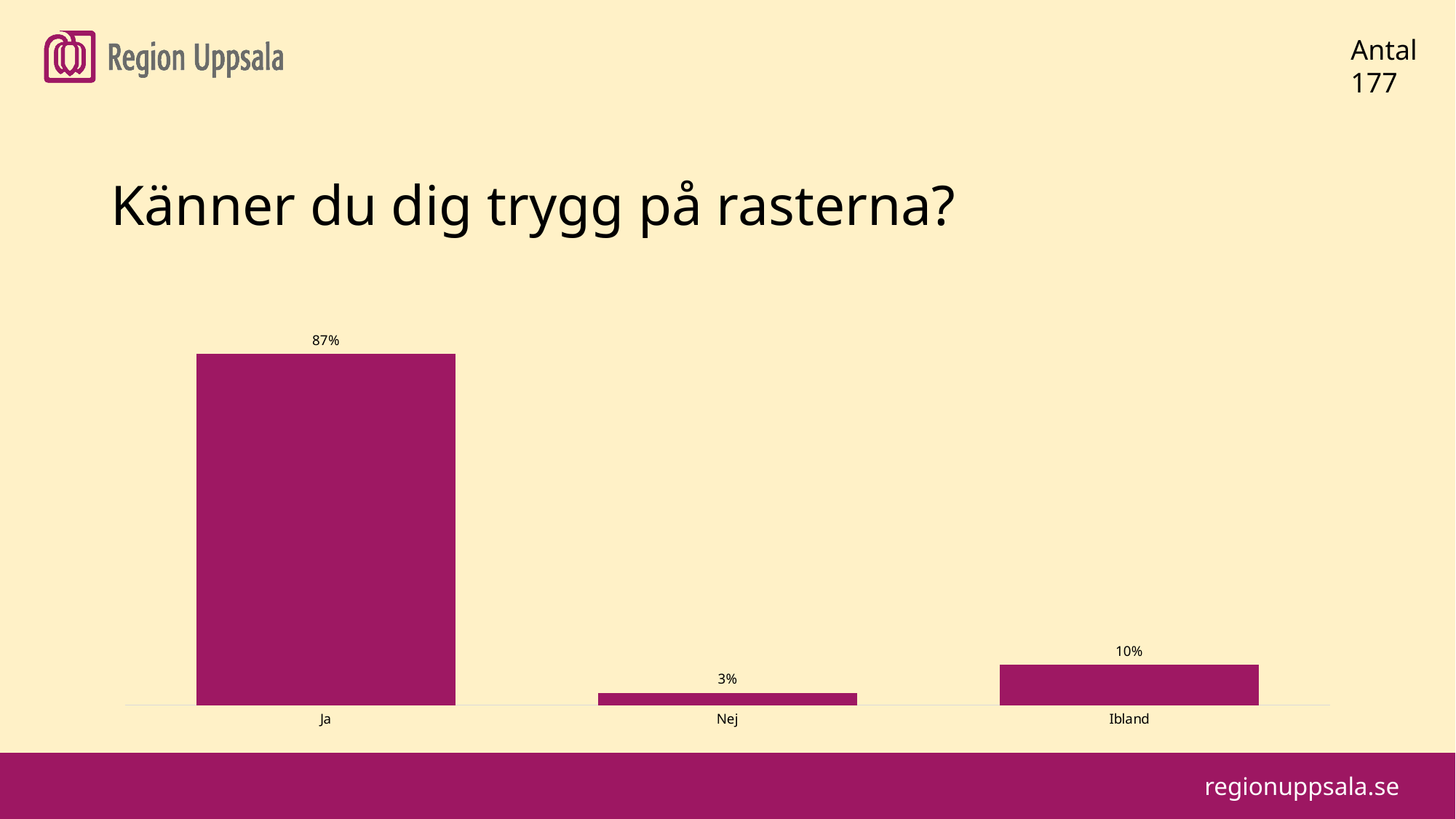
What is the title of the slide above the chart? Känner du dig trygg på rasterna? Which category has the highest value? Ja What is the difference between the values for Ja and Ibland? 77% How many categories are shown on the x axis? 3 What is the value for Ja? 87% What number is shown next to "Antal" in the top right corner of the slide? 177 Which is larger, the value for Nej or the value for Ibland? Ibland What is the value for Ibland? 10% Which category has the lowest value? Nej What is the difference between the values for Ibland and Nej? 7% What is the value for Nej? 3% What kind of chart is shown on the slide? Bar chart